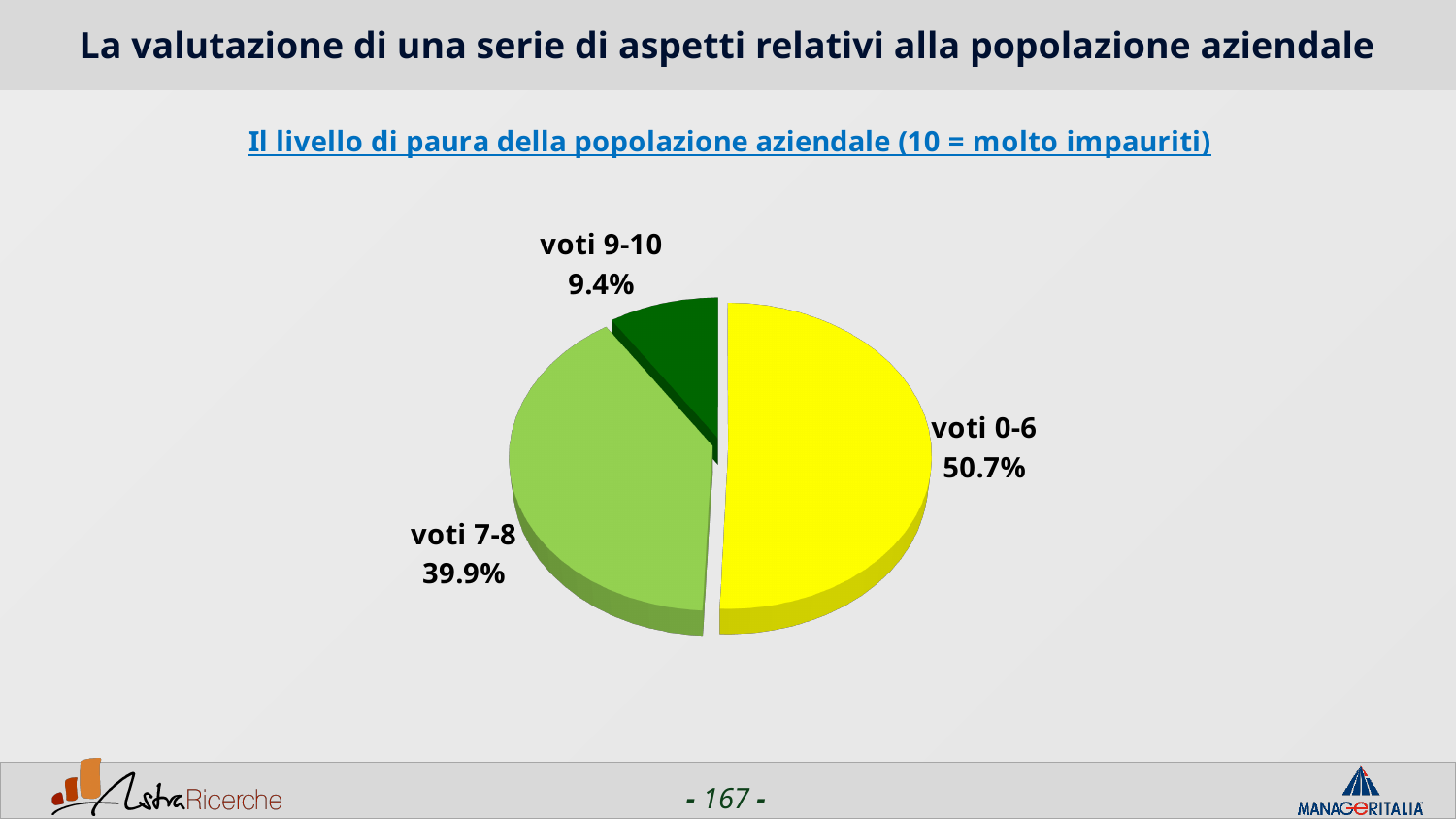
How many slices does the pie chart have? 3 What is the difference in percentage points between 'voti 7-8' and 'voti 9-10'? 30.5 Which is larger, the share for 'voti 7-8' or the share for 'voti 9-10'? voti 7-8 What colour is the 'voti 0-6' slice? Yellow What share of the pie does the 'voti 0-6' slice represent? 50.7% What is the value shown for 'voti 9-10'? 9.4% Which category has the largest slice of the pie? voti 0-6 Which category has the smallest slice of the pie? voti 9-10 What is the title of the chart? Il livello di paura della popolazione aziendale (10 = molto impauriti) What is the difference in percentage points between 'voti 0-6' and 'voti 7-8'? 10.8 What is the value shown for 'voti 7-8'? 39.9% What kind of chart is shown on the slide? Pie chart